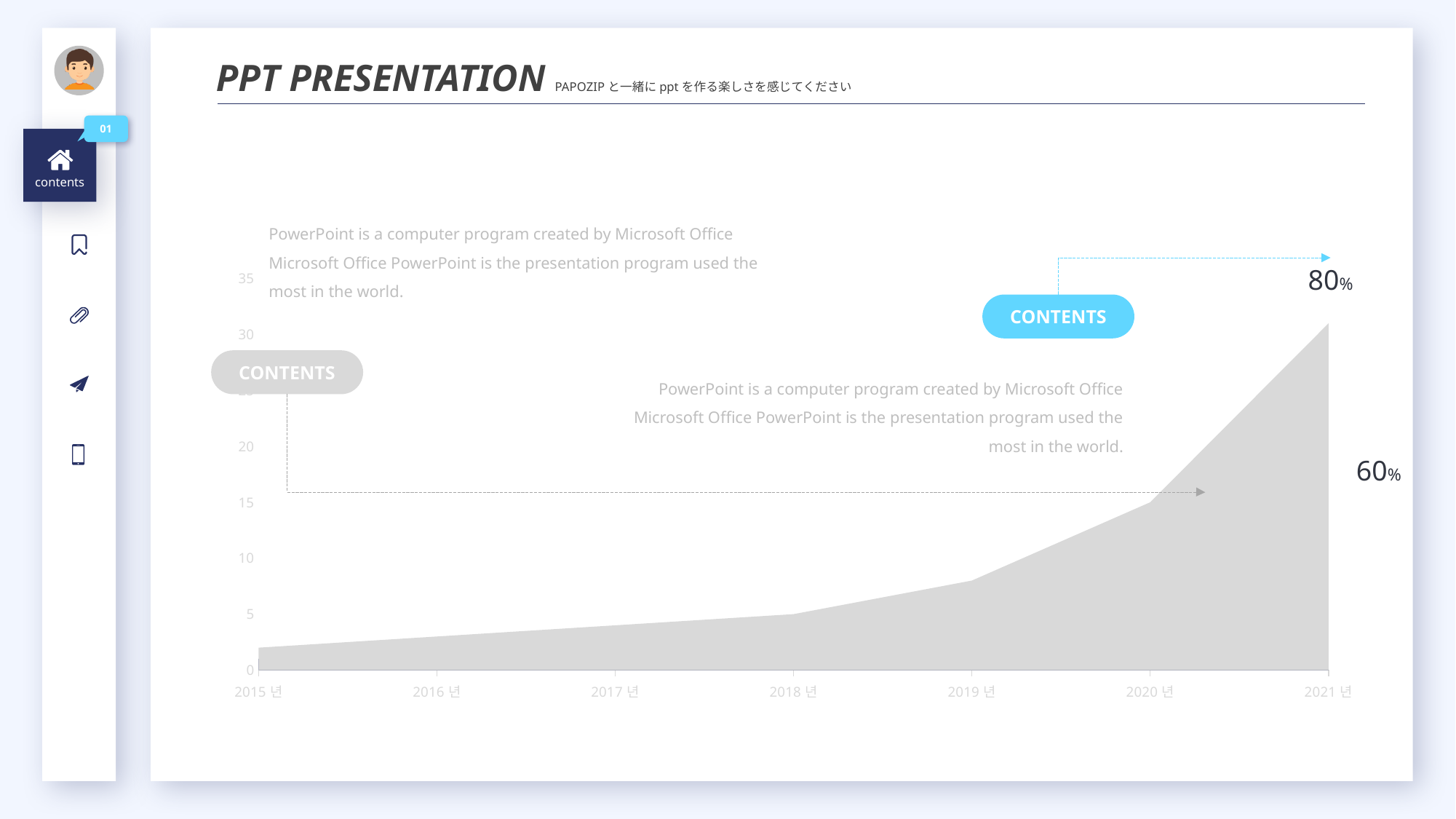
Which is larger, the value for 2020년 or the value for 2019년? 2020년 Is the value for 2020년 greater or less than 10? greater Which year has the lowest value in the chart? 2015년 What kind of chart is shown on the slide? area chart Is the value for 2021년 greater or less than 25? greater Which is larger, the value for 2016년 or the value for 2021년? 2021년 What is the highest tick label shown on the y axis of the chart? 35 Is the value for 2015년 greater or less than 5? less Do the values in the chart rise or fall from 2015년 to 2021년? rise How many years are shown along the x axis of the chart? 7 Which year has the highest value in the chart? 2021년